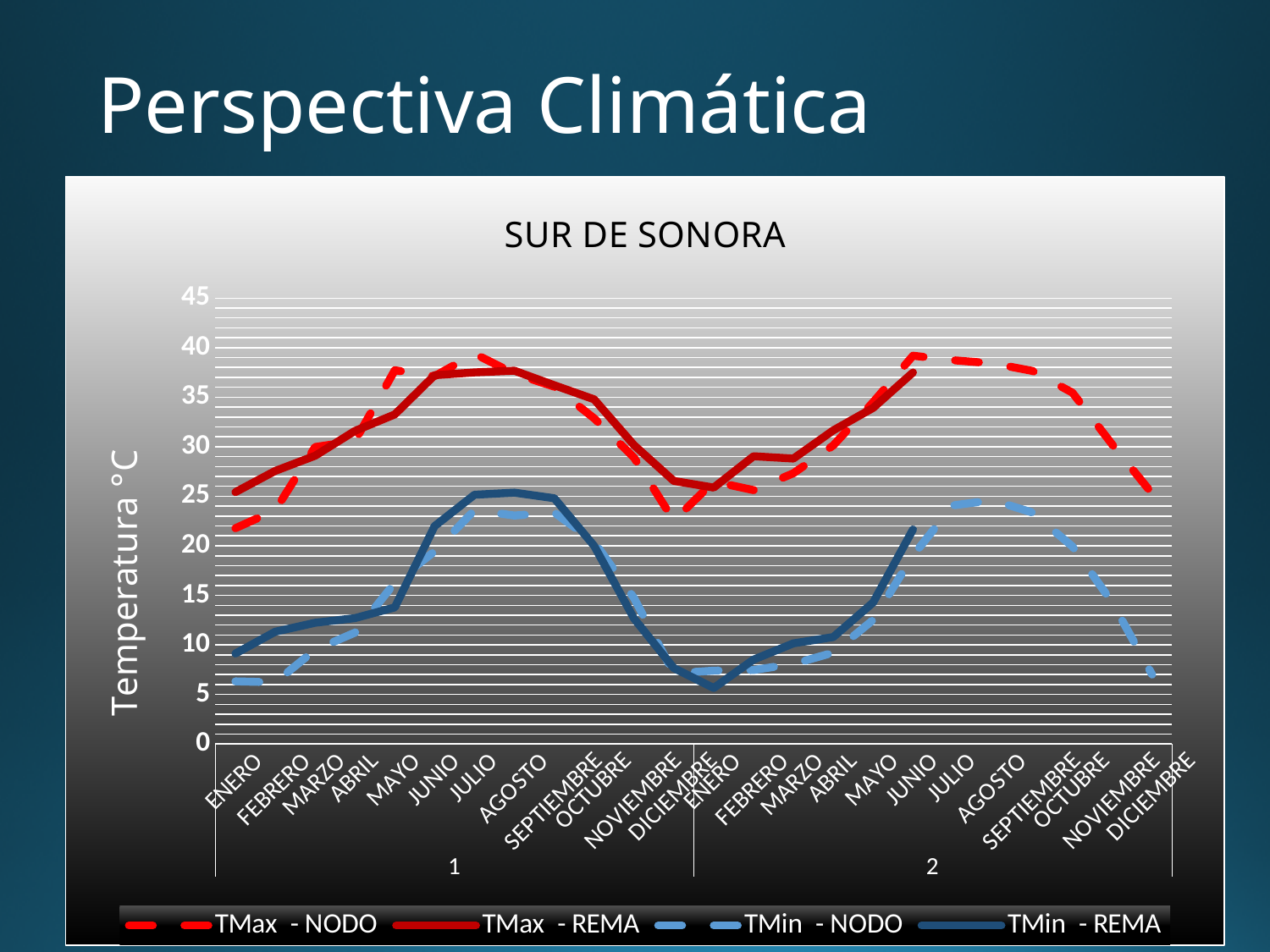
What is the title of the chart? SUR DE SONORA Is the value for TMin - NODO in JULIO of year 2 greater or less than 20? greater Is the value for TMin - NODO in ENERO of year 1 greater or less than 10? less What is the label of the vertical axis of the chart? Temperatura °C In JUNIO of year 1, which is larger: TMax - REMA or TMin - REMA? TMax - REMA Is the value for TMin - REMA in DICIEMBRE of year 1 greater or less than 10? less How many series does the legend of the chart list? 4 Does the TMax - REMA line rise or fall from ENERO to JULIO of year 1? rise What kind of chart is shown on the slide? line chart Does the TMin - REMA line rise or fall from JULIO to DICIEMBRE of year 1? fall